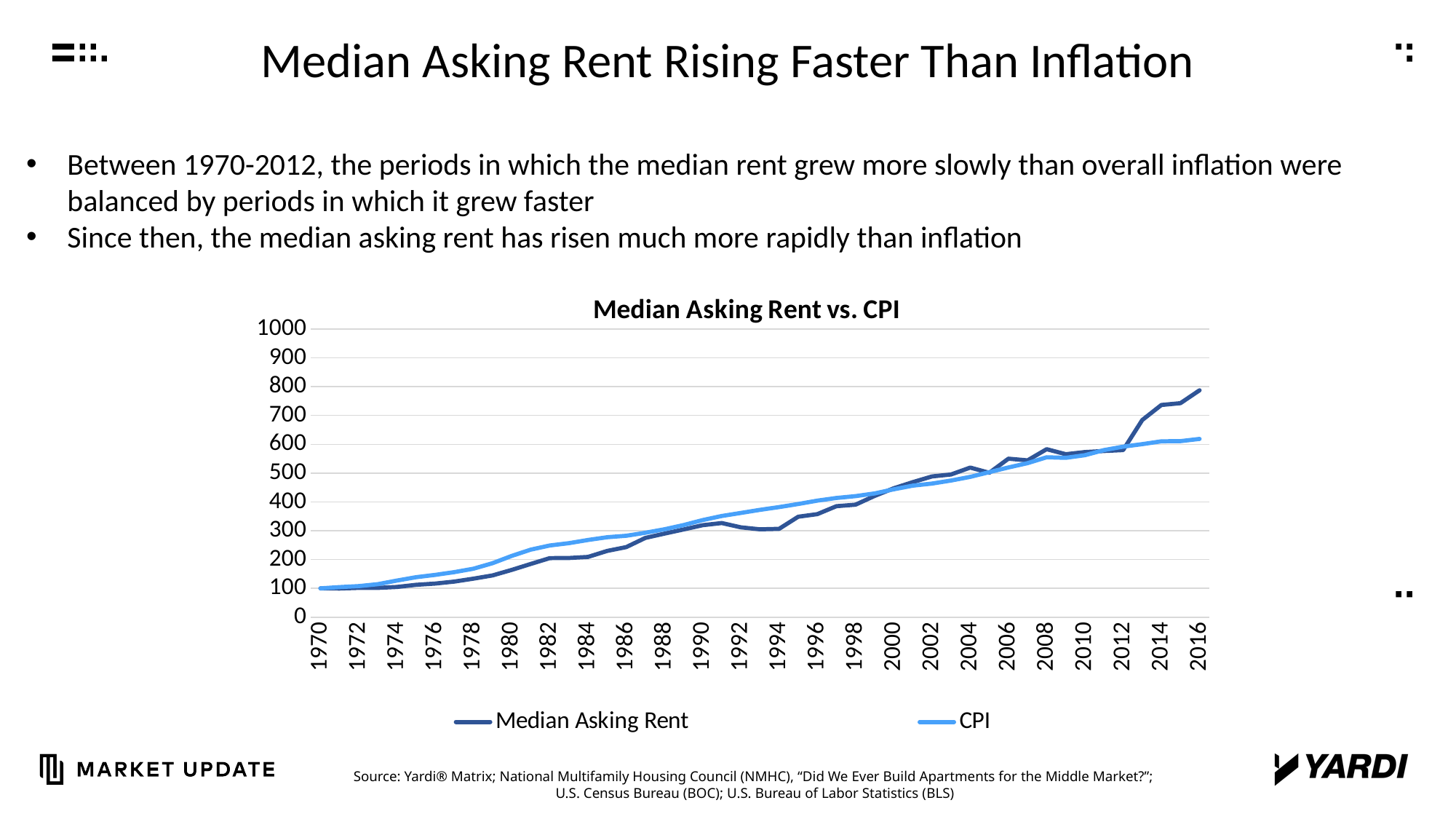
Is the value for CPI in 2016 greater or less than 700? less What kind of chart is shown on the slide? Line chart How many series does the legend list? 2 What is the value of Median Asking Rent in 1970? 100 What is the title of the chart? Median Asking Rent vs. CPI Is the value for Median Asking Rent in 2016 greater or less than 700? greater Is the value for CPI in 1982 greater or less than 200? greater What are the two series named in the legend? Median Asking Rent and CPI In 2016, which series has the higher value, Median Asking Rent or CPI? Median Asking Rent What is the value of CPI in 1970? 100 In 1994, which series has the higher value, Median Asking Rent or CPI? CPI